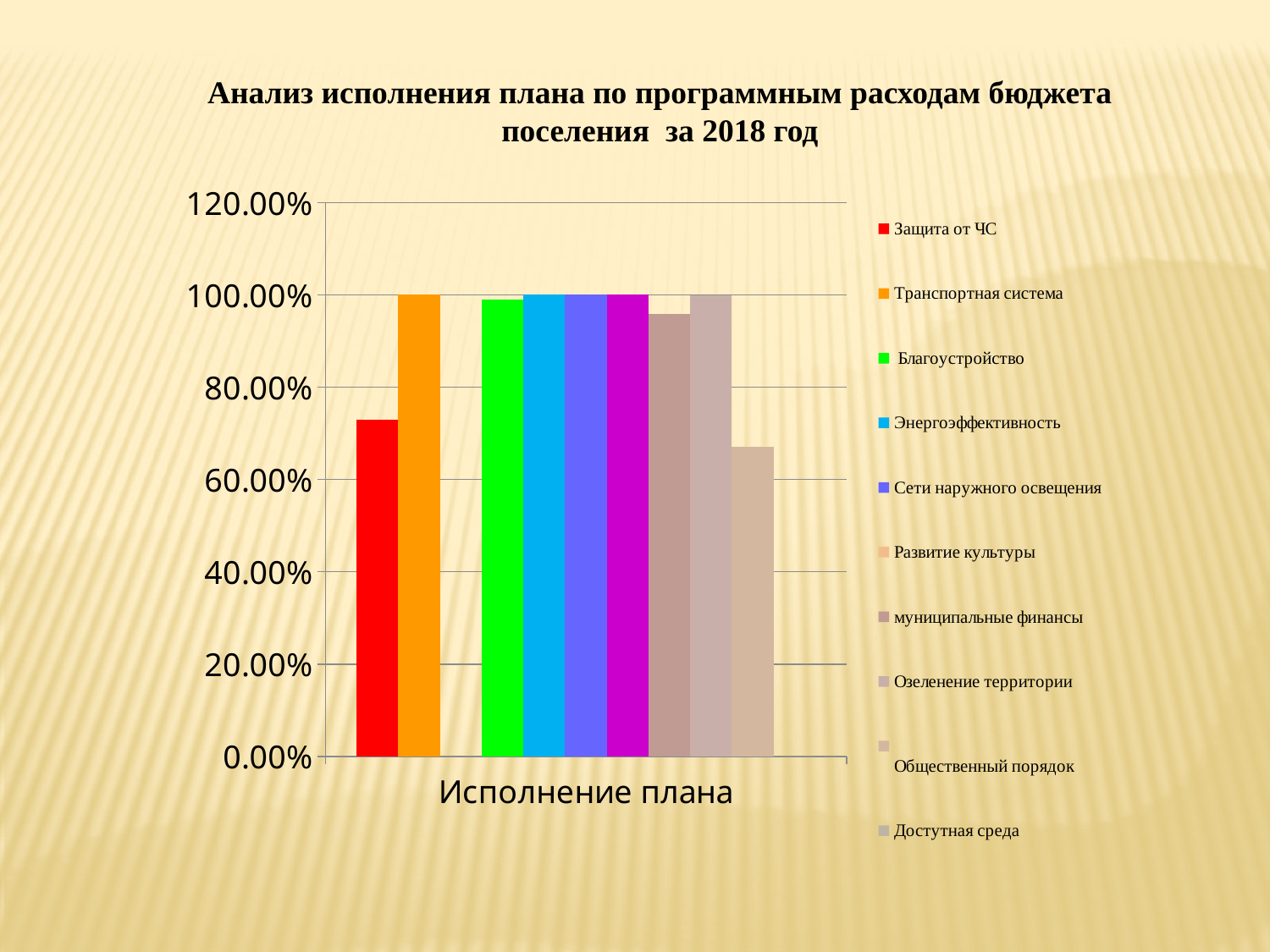
What kind of chart is shown on the slide? bar chart Is the value for Защита от ЧС greater or less than 60.00%? greater Is the value for Транспортная система greater or less than 80.00%? greater How many series does the legend list? 10 How many categories are shown on the x axis? 1 Is the value for Защита от ЧС greater or less than 80.00%? less What is the title of the chart? Анализ исполнения плана по программным расходам бюджета поселения за 2018 год Which is larger, the value for Защита от ЧС or the value for Энергоэффективность? Энергоэффективность What is the category label on the x axis? Исполнение плана Which is larger, the value for Защита от ЧС or the value for Транспортная система? Транспортная система